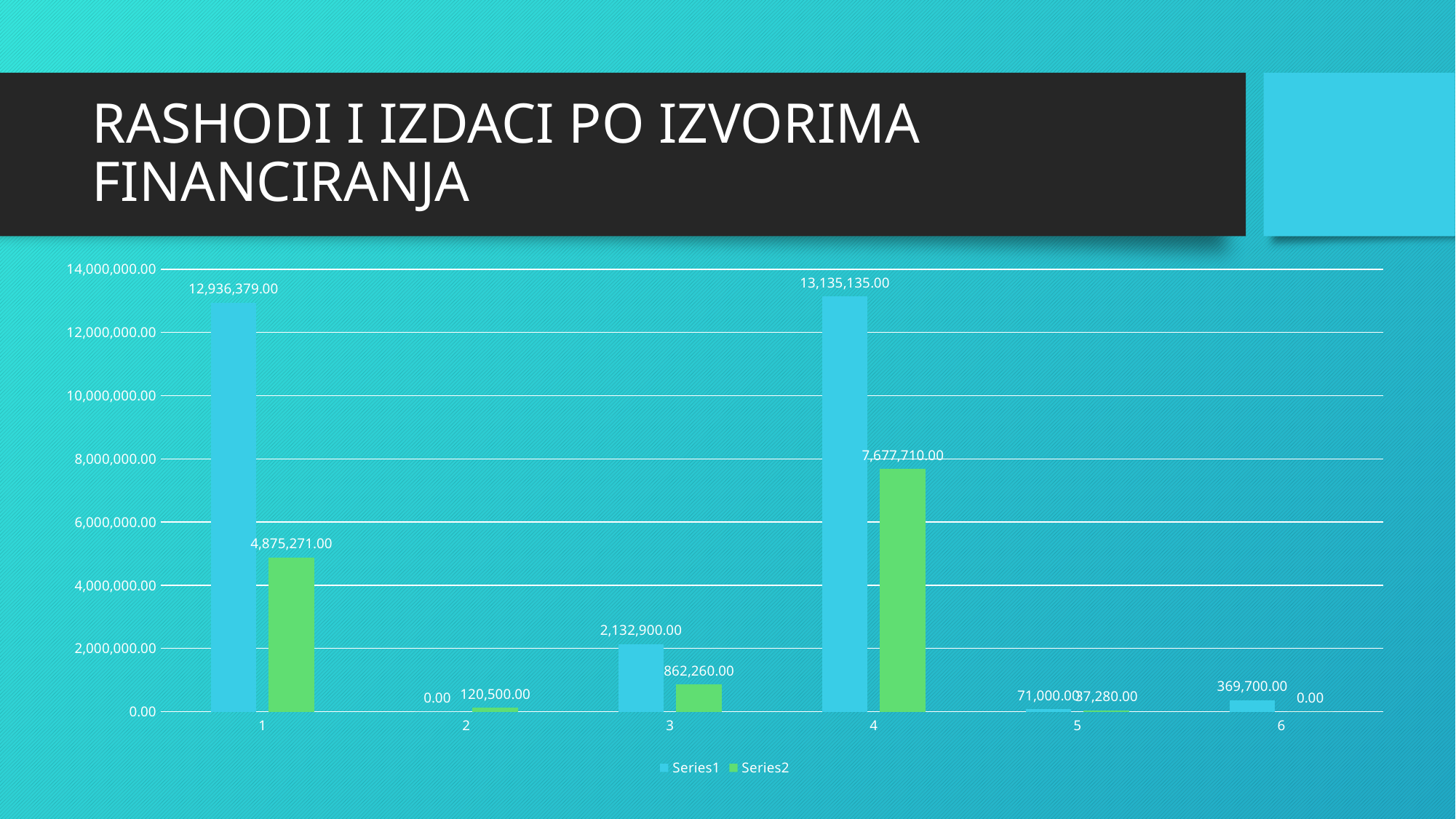
What kind of chart is shown on the slide? bar chart Which category has the highest Series1 value? 4 What is the value of Series2 for category 2? 120,500.00 What is the difference between Series1 and Series2 for category 3? 1,270,640.00 Which category has the lowest Series1 value? 2 What is the difference between the Series1 values for category 4 and category 1? 198,756.00 What are the two entries listed in the legend? Series1 and Series2 How many categories are shown on the x axis? 6 For category 3, which series has the larger value, Series1 or Series2? Series1 How many series does the legend list? 2 What is the value of Series2 for category 4? 7,677,710.00 What is the value of Series1 for category 1? 12,936,379.00